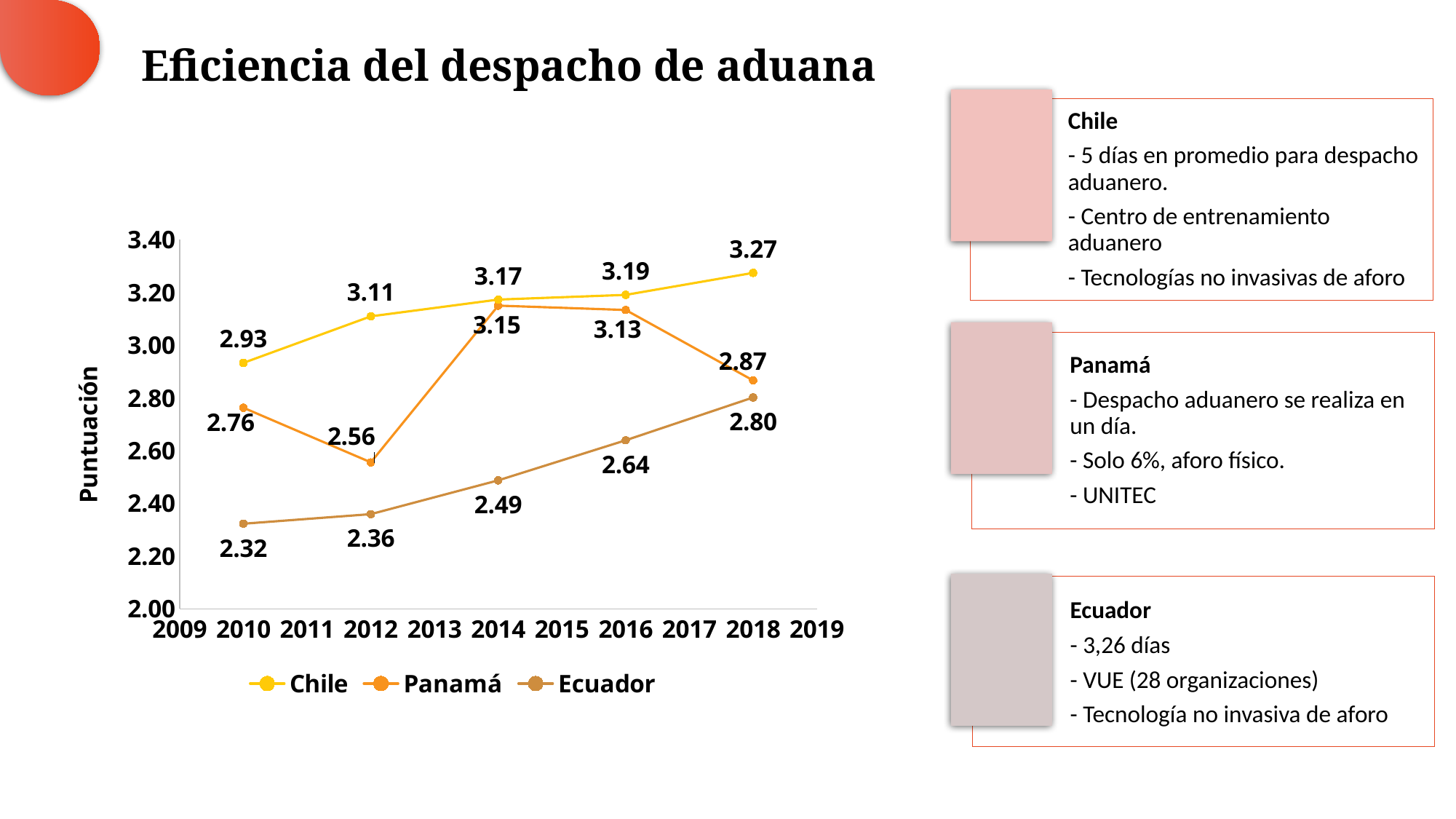
How many data points are plotted for the Ecuador series? 5 What is the value for Chile in 2018? 3.27 What is the difference between Chile and Ecuador in 2010? 0.61 Which series has the higher value in 2016, Panamá or Ecuador? Panamá What is the value for Panamá in 2012? 2.56 What is the label of the vertical axis? Puntuación What kind of chart is shown on the slide? Line chart Do the values for Ecuador rise or fall from 2010 to 2018? Rise In which year does Chile reach its highest value? 2018 In which year does Panamá have its lowest value? 2012 What is the value for Ecuador in 2014? 2.49 How many series does the legend list? 3